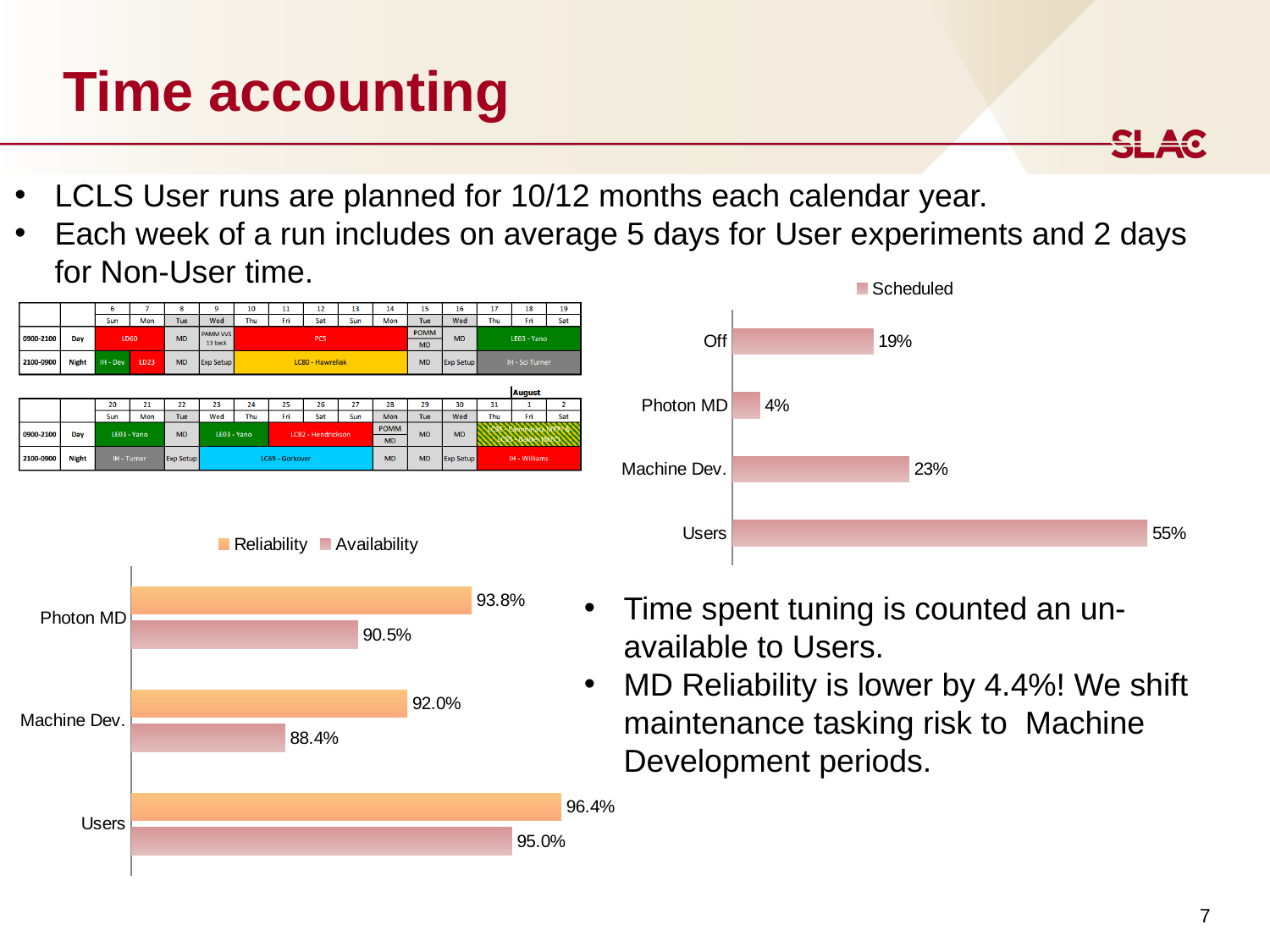
In the 'Scheduled' bar chart on the right, what is the value for Users? 55% In the 'Scheduled' bar chart on the right, which category has the highest value? Users In the Reliability/Availability bar chart at the bottom left, what is the Availability value for Photon MD? 90.5% In the Reliability/Availability bar chart at the bottom left, what is the Reliability value for Machine Dev.? 92.0% In the 'Scheduled' bar chart on the right, what is the difference between Machine Dev. and Off? 4% In the Reliability/Availability bar chart at the bottom left, how many series does the legend list? 2 In the 'Scheduled' bar chart on the right, how many categories are shown? 4 What kind of chart is the 'Scheduled' chart on the right? Bar chart In the 'Scheduled' bar chart on the right, what is the value for Photon MD? 4% In the Reliability/Availability bar chart at the bottom left, which category has the highest Reliability? Users In the Reliability/Availability bar chart at the bottom left, what is the difference between Reliability and Availability for Users? 1.4% In the 'Scheduled' bar chart on the right, which category has the lowest value? Photon MD